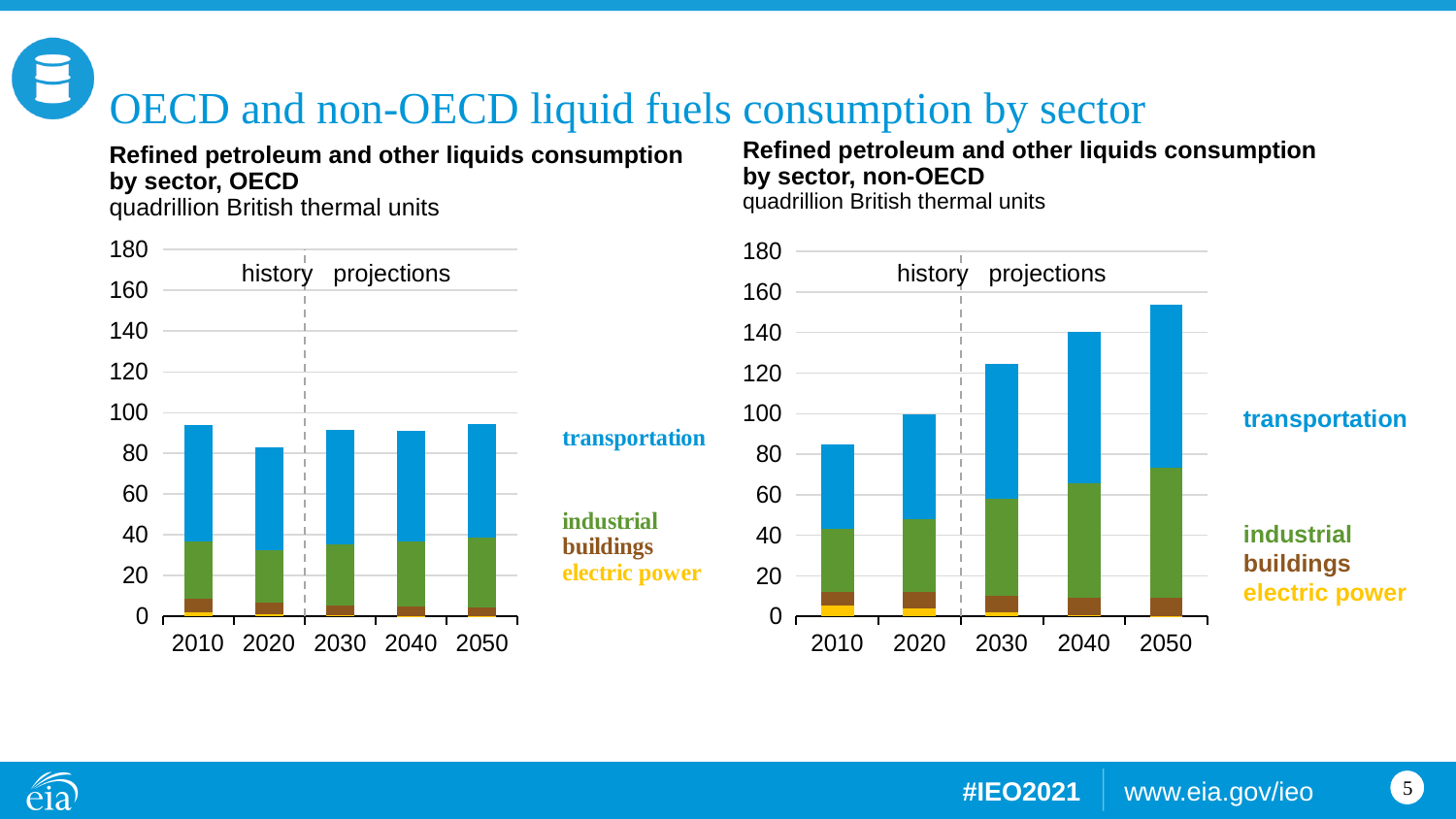
Which is larger in 2050: the total for the OECD chart or the total for the non-OECD chart? non-OECD In the non-OECD chart, is the total value for 2050 greater or less than 140? greater What unit is used on the y axis of both charts? quadrillion British thermal units How many sectors (series) are listed in the legend of the non-OECD chart? 4 In the non-OECD chart, is the total value for 2010 greater or less than 100? less How many years are shown on the x axis of the OECD chart? 5 In the OECD chart, which year has the lowest total consumption? 2020 In the non-OECD chart, which year has the highest total consumption? 2050 What type of chart is used in the 'Refined petroleum and other liquids consumption by sector, OECD' chart? Stacked bar chart In the non-OECD chart, do total consumption values rise or fall from 2010 to 2050? rise In the non-OECD chart, which year has the lowest total consumption? 2010 In the OECD chart, is the total value for 2020 greater or less than 100? less